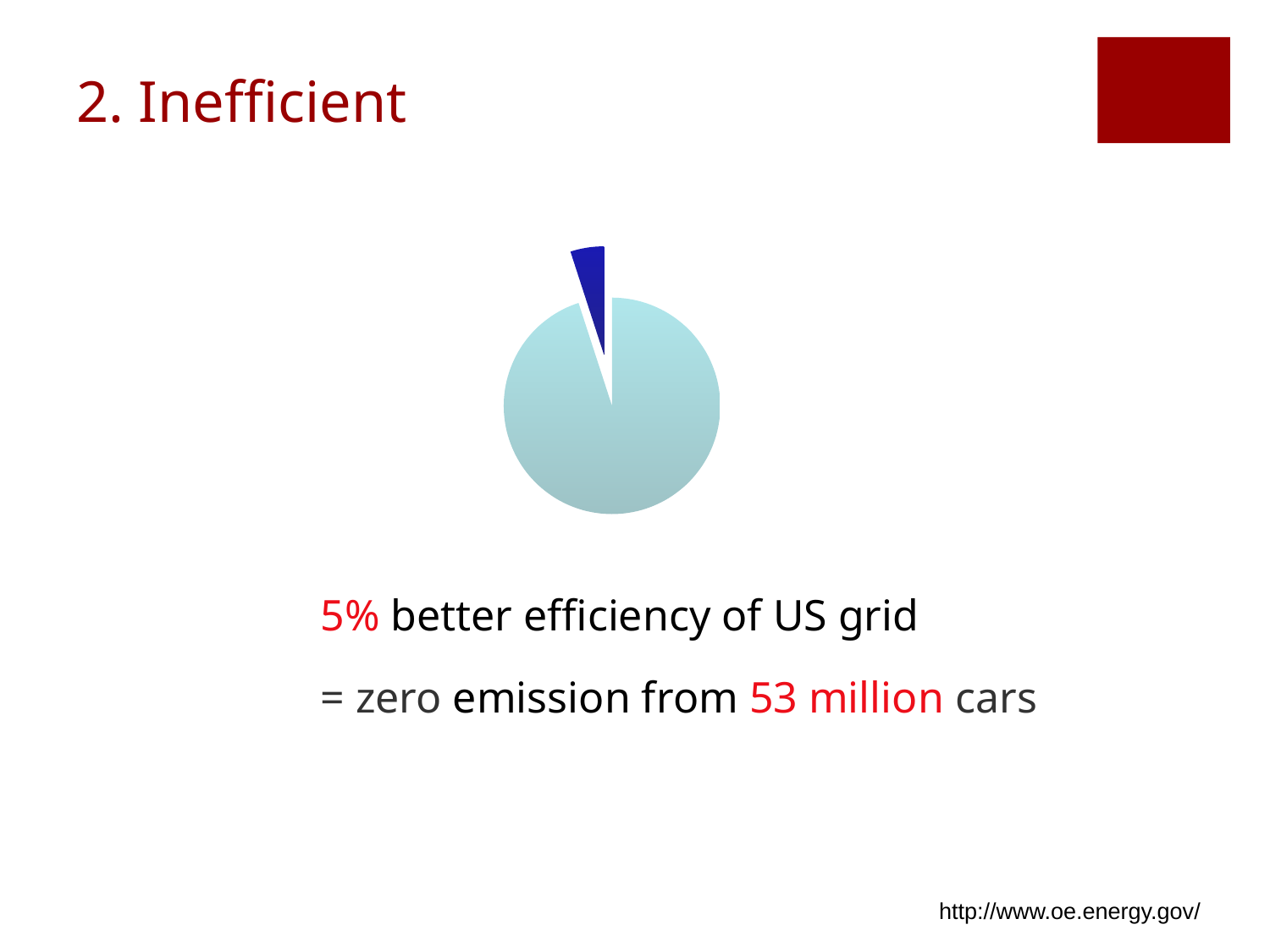
Which slice of the pie chart is larger, the light blue slice or the dark blue slice? the light blue slice Is the dark blue slice of the pie chart pulled out (exploded) from the rest of the pie? yes Which slice of the pie chart is the largest? the light blue slice What kind of chart is shown on the slide? pie chart Does the pie chart display a legend? no How many slices does the pie chart have? 2 Which slice of the pie chart is the smallest? the dark blue slice